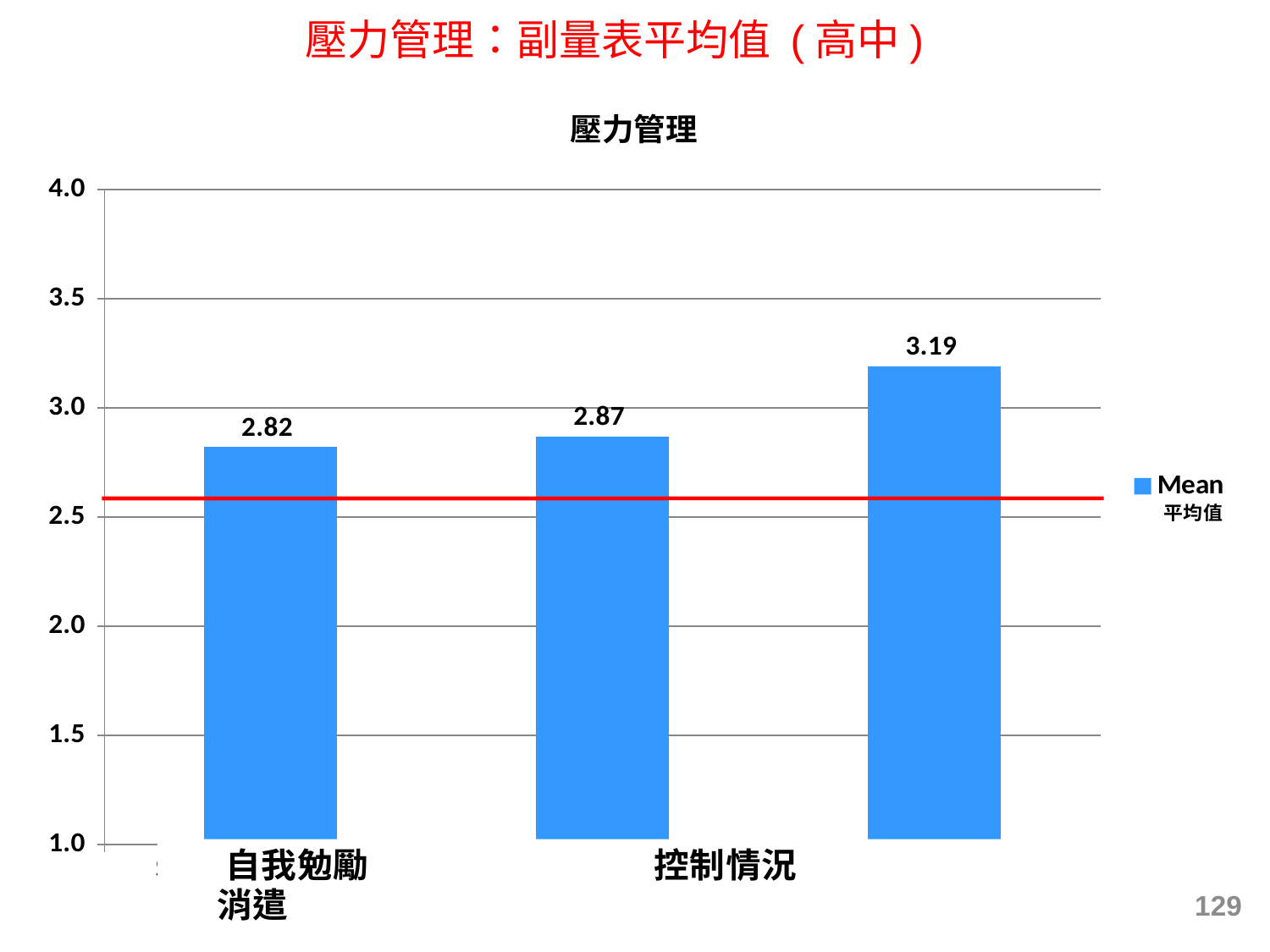
Which bar has the highest value? The rightmost bar (3.19) Which labelled category has the lowest value? 自我勉勵 How many bars are plotted in the chart? 3 Which is larger, the value for 控制情況 or the value for 自我勉勵? 控制情況 How many series does the legend list? 1 What is the value of the bar labelled 控制情況? 2.87 Is the value for 自我勉勵 greater or less than 3.0? less What is the value of the rightmost bar in the chart? 3.19 What is the difference between the values for 控制情況 and 自我勉勵? 0.05 What type of chart is shown on the slide? Bar chart What is the difference between the rightmost bar (3.19) and the bar for 自我勉勵? 0.37 What is the value of the bar labelled 自我勉勵? 2.82